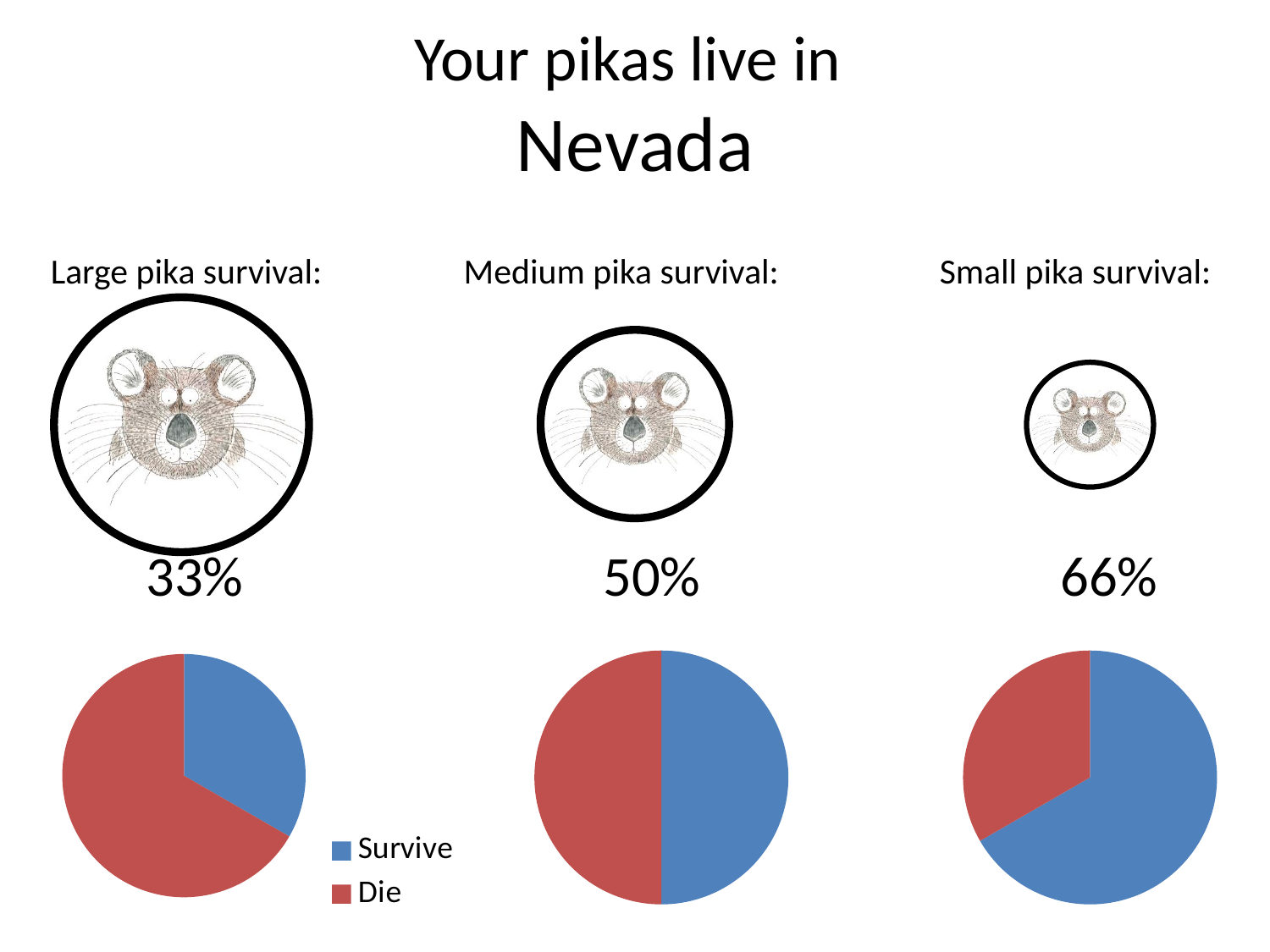
Which pika size has the highest survival percentage? Small pika How many pie charts are shown on the slide? 3 How many entries does the legend list for the pie charts? 2 What kind of chart is used to show pika survival on this slide? pie chart What is the difference between the Small pika survival percentage and the Large pika survival percentage? 33% Which pika size has the lowest survival percentage? Large pika In the Small pika survival pie chart, what share of pikas survive? 66% In the Large pika survival pie chart, which slice is larger, Survive or Die? Die In the Small pika survival pie chart, which slice is larger, Survive or Die? Survive In the Medium pika survival pie chart, what share of pikas die? 50% In the Medium pika survival pie chart, what share of pikas survive? 50%